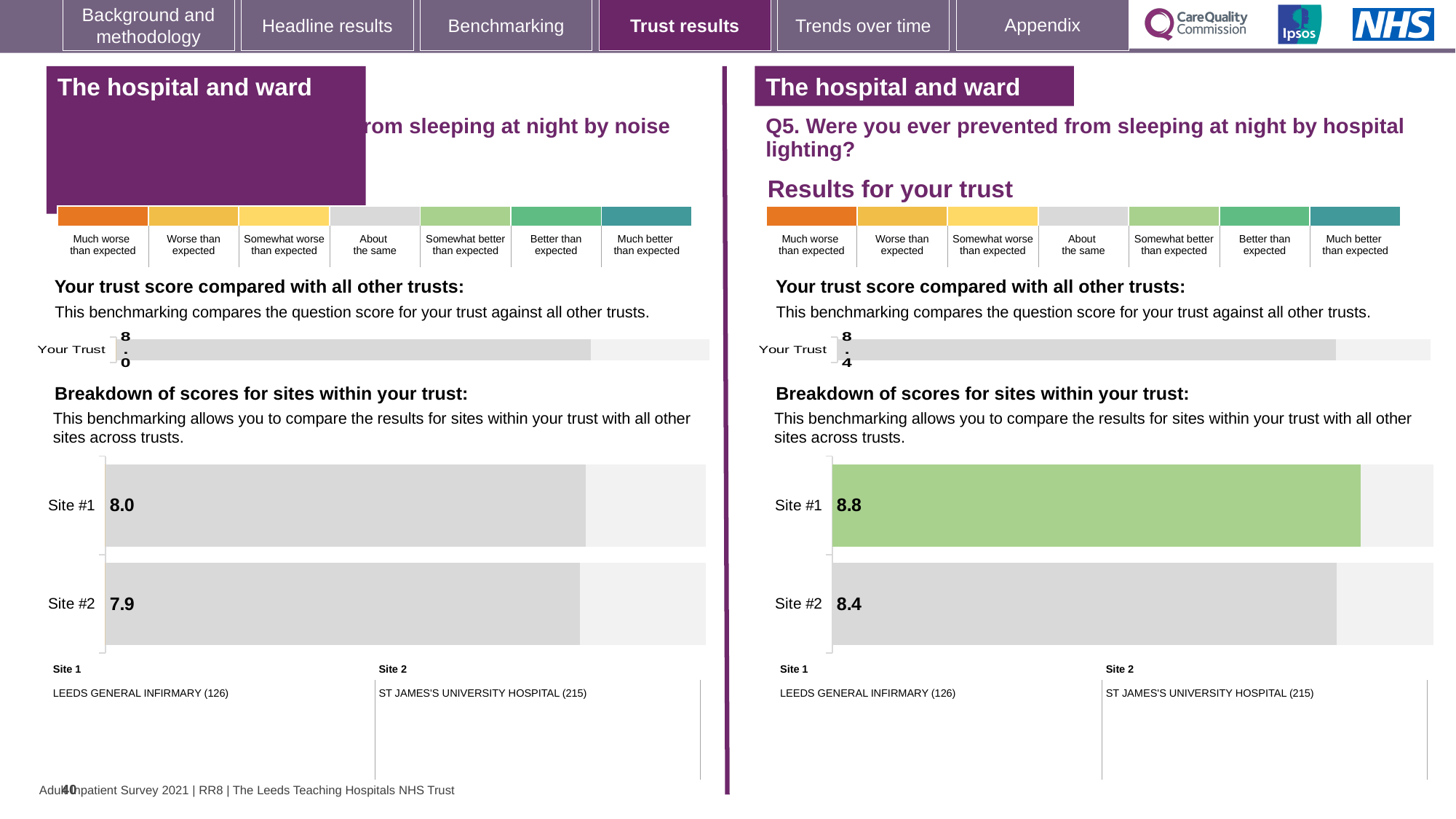
On the right half of the slide (Q5, hospital lighting), what is the 'Your Trust' score in the chart comparing the trust with all other trusts? 8.4 On the left half of the slide (the question about noise), what is the score for Site #2 in the breakdown of scores for sites within your trust? 7.9 On the left half of the slide (the question about noise), what is the 'Your Trust' score in the chart comparing the trust with all other trusts? 8.0 How many sites are shown in the site breakdown chart on the right half of the slide (Q5, hospital lighting)? 2 On the right half of the slide (Q5, hospital lighting), what is the score for Site #1 in the breakdown of scores for sites within your trust? 8.8 On the right half of the slide (Q5, hospital lighting), which site's bar in the site breakdown chart is coloured green rather than grey? Site #1 On the right half of the slide (Q5, hospital lighting), which site has the higher score in the site breakdown chart? Site #1 What type of chart is used for the breakdown of scores for sites on the right half of the slide (Q5, hospital lighting)? Bar chart On the left half of the slide (the question about noise), what is the difference between the Site #1 and Site #2 scores in the site breakdown chart? 0.1 On the left half of the slide (the question about noise), what is the score for Site #1 in the breakdown of scores for sites within your trust? 8.0 On the right half of the slide (Q5, hospital lighting), what is the difference between the Site #1 and Site #2 scores in the site breakdown chart? 0.4 On the right half of the slide (Q5, hospital lighting), what is the score for Site #2 in the breakdown of scores for sites within your trust? 8.4